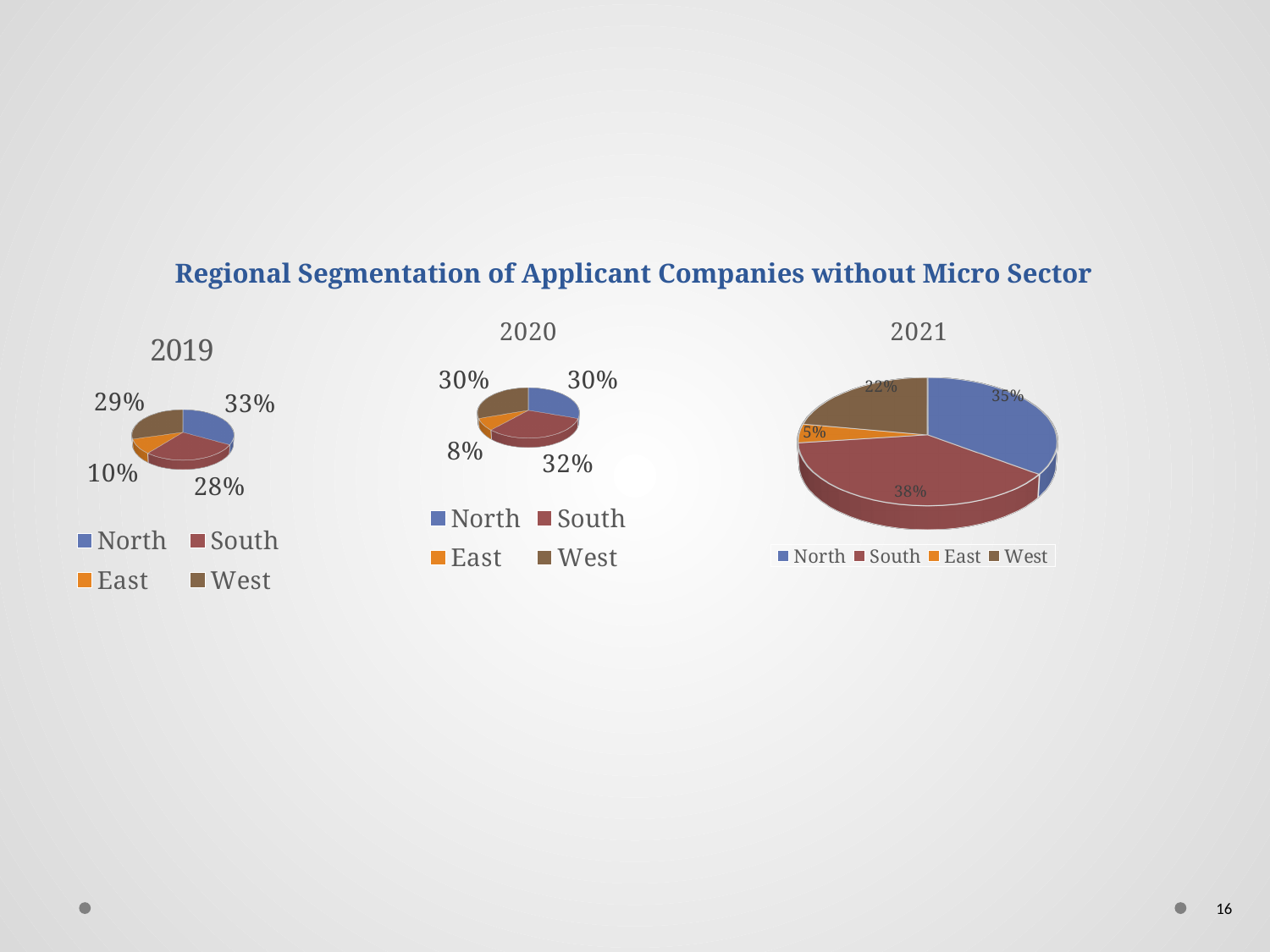
In the 2019 pie chart, what share does North have? 33% In the 2021 pie chart, which region has the largest share? South In the 2021 pie chart, what is the difference between the South share and the North share? 3% In the 2019 pie chart, which is larger, the share for South or the share for West? West What type of chart is used for the 2021 data? Pie chart In the 2020 pie chart, what share does South have? 32% In the 2019 pie chart, what share does East have? 10% In the 2019 pie chart, which region has the smallest share? East How many regions does the legend of the 2020 pie chart list? 4 In the 2021 pie chart, what share does West have? 22% In the 2020 pie chart, which region has the smallest share? East How many pie charts are shown on the slide? 3